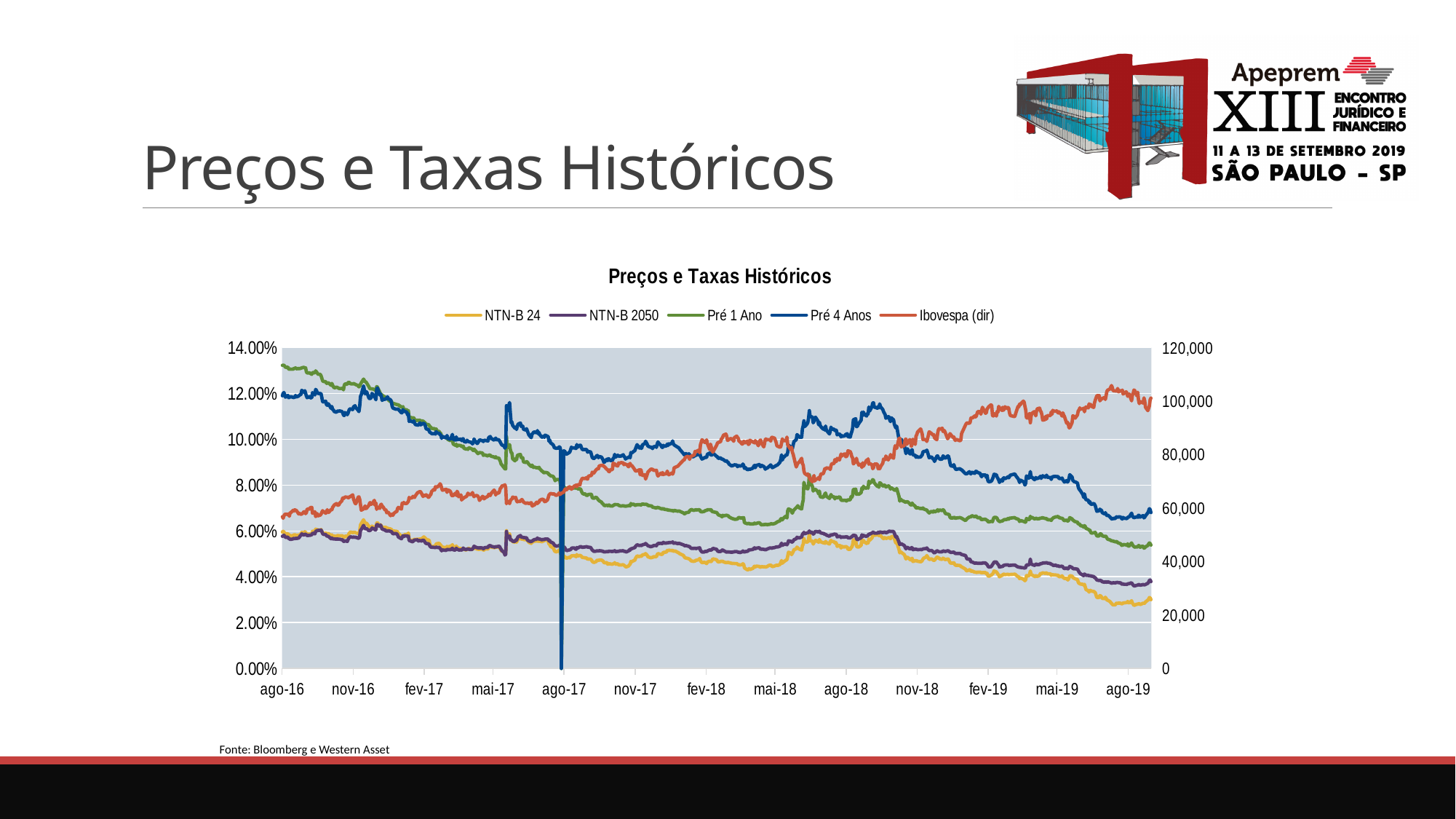
Is the value for NTN-B 24 at ago-19 greater or less than 4.00%? less Does the Ibovespa (dir) series rise or fall overall from ago-16 to ago-19? rise How many series does the legend list? 5 At ago-19, which is higher, NTN-B 2050 or NTN-B 24? NTN-B 2050 At ago-16, which is higher, Pré 1 Ano or Pré 4 Anos? Pré 1 Ano Which series is plotted against the right-hand axis? Ibovespa (dir) What kind of chart is shown on the slide? line chart What is the title of the chart? Preços e Taxas Históricos Is the value for Pré 1 Ano at ago-16 greater or less than 12.00%? greater Is the value for Ibovespa (dir) at ago-19 greater or less than 80,000? greater Does the Pré 1 Ano series rise or fall overall from ago-16 to ago-19? fall Does the Pré 4 Anos series rise or fall overall from ago-16 to ago-19? fall